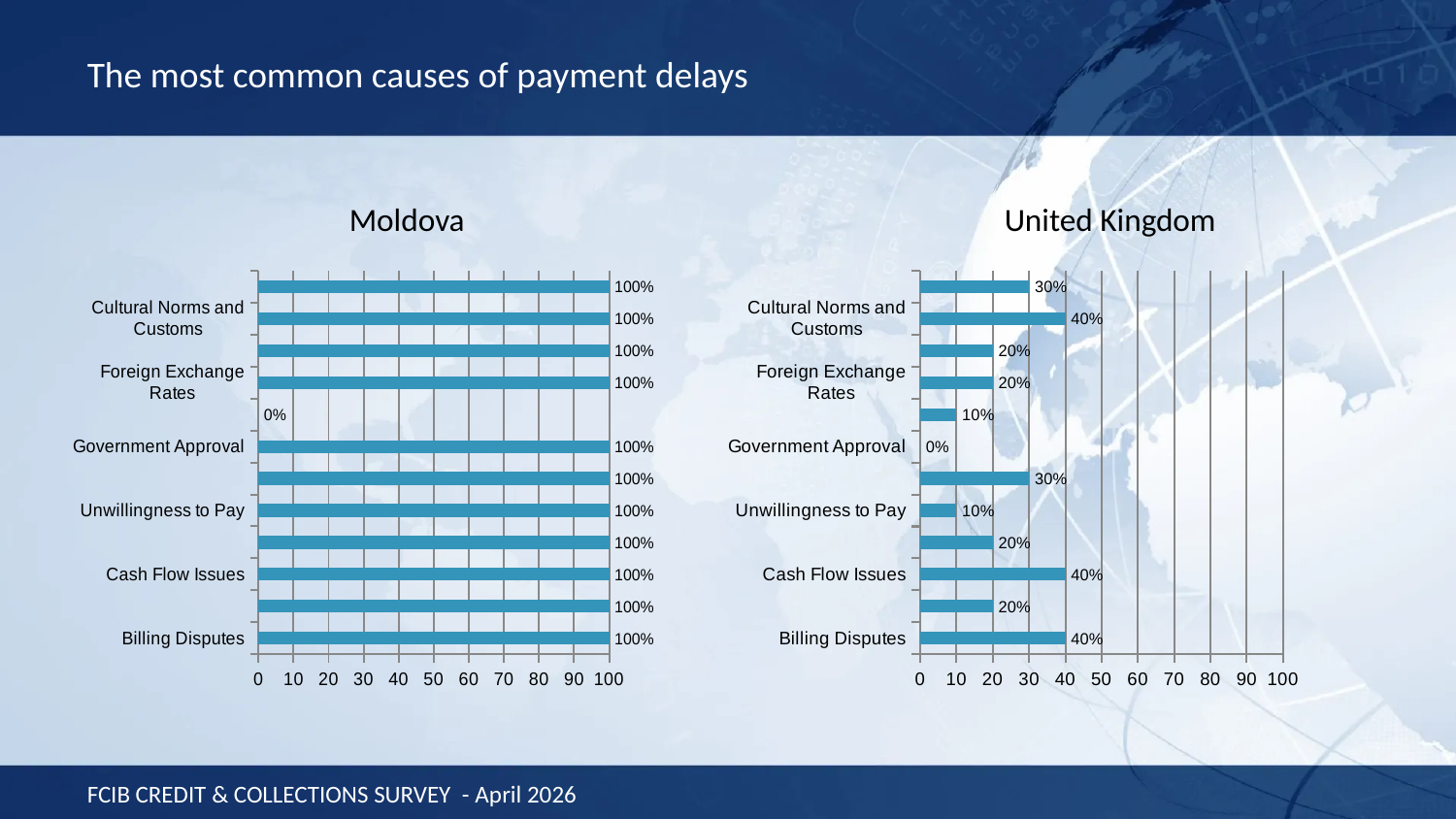
In the Moldova chart, what is the value for Cash Flow Issues? 100% How many category labels are shown on the vertical axis of the United Kingdom chart? 6 In the United Kingdom chart, what is the value for Unwillingness to Pay? 10% In the United Kingdom chart, what is the value for Government Approval? 0% In the United Kingdom chart, which is larger, Billing Disputes or Foreign Exchange Rates? Billing Disputes In the United Kingdom chart, what is the value for Cultural Norms and Customs? 40% In the Moldova chart, what is the value for Billing Disputes? 100% In the United Kingdom chart, what is the difference between Cash Flow Issues and Unwillingness to Pay? 30% What kind of chart is the Moldova chart? bar chart In the United Kingdom chart, what is the value for Foreign Exchange Rates? 20% Is the value for Cash Flow Issues in the Moldova chart greater or less than the value for Cash Flow Issues in the United Kingdom chart? greater In the United Kingdom chart, which labeled category has the lowest value? Government Approval